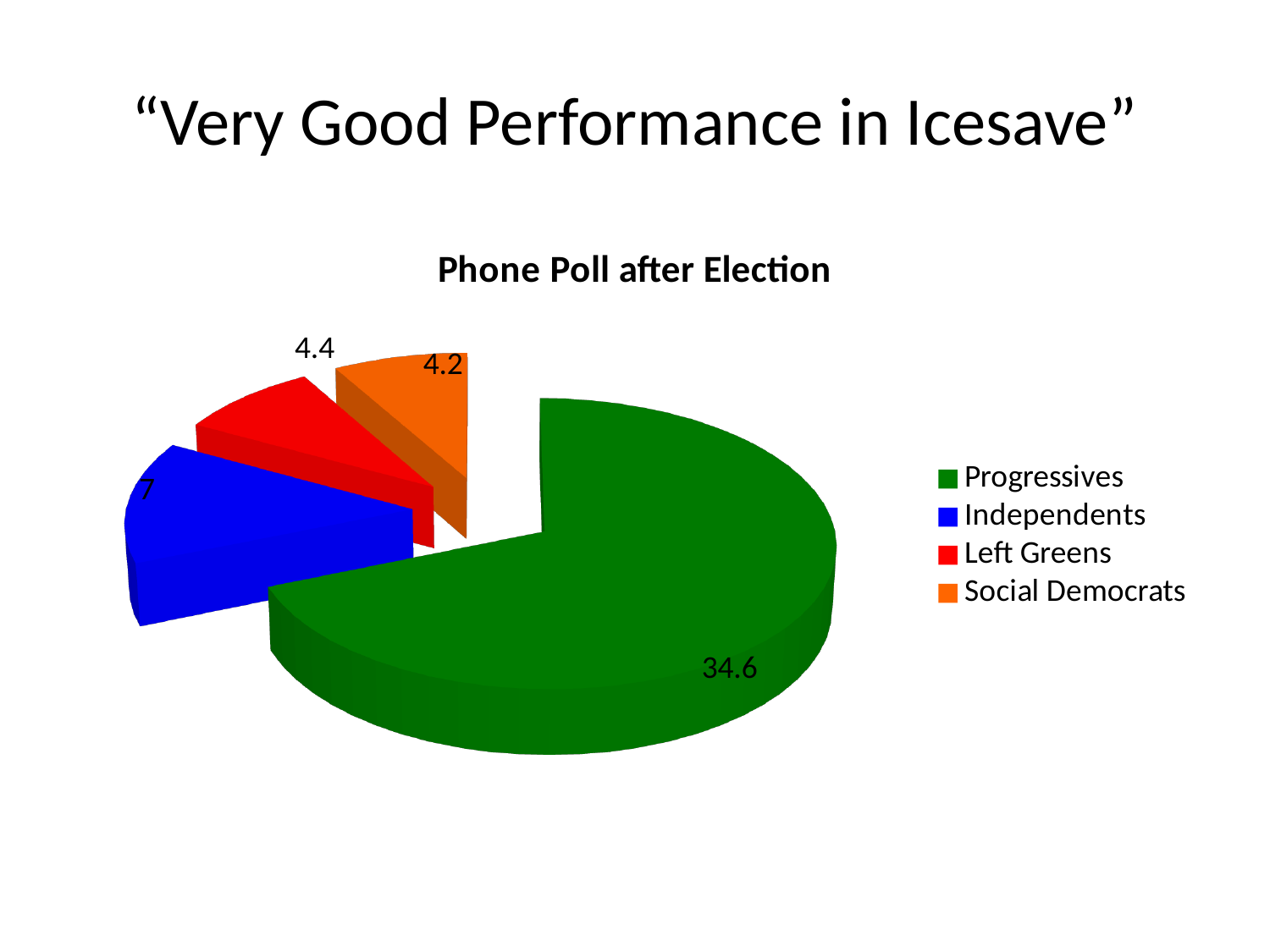
Which is larger, the value for Independents or the value for Left Greens? Independents What is the value for Social Democrats? 4.2 How many categories does the legend list? 4 What is the value for Progressives? 34.6 What is the difference between the values for Left Greens and Social Democrats? 0.2 Which party has the largest slice of the pie? Progressives Which party has the smallest slice of the pie? Social Democrats What type of chart is shown on the slide? Pie chart What is the title of the chart? Phone Poll after Election What is the value for Independents? 7 What is the value for Left Greens? 4.4 What is the difference between the values for Progressives and Independents? 27.6